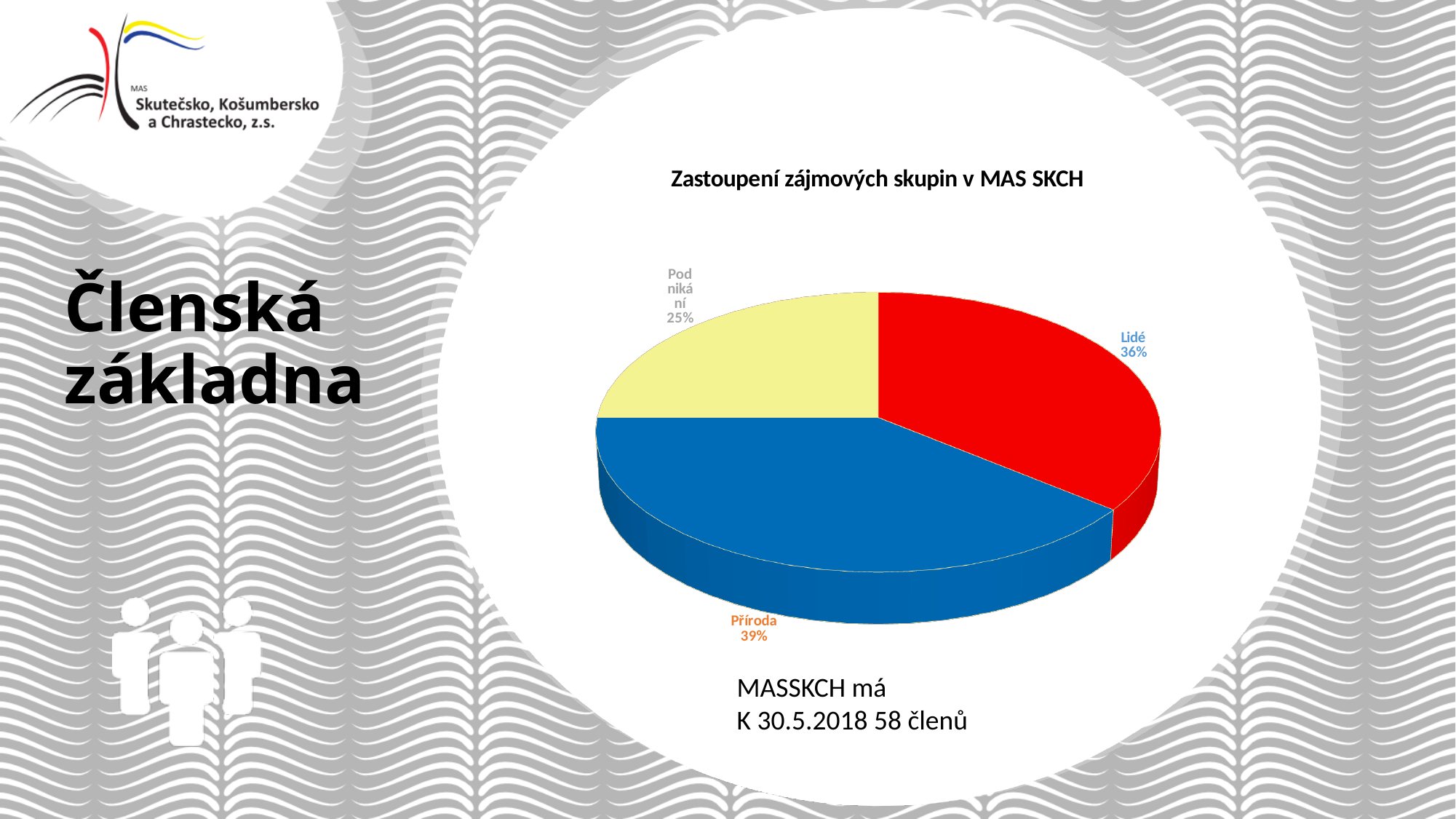
What colour is the Příroda slice of the pie chart? blue What kind of chart is shown on the slide? pie chart Which slice of the pie chart is the largest? Příroda What share of the pie does Lidé have? 36% What is the title of the chart? Zastoupení zájmových skupin v MAS SKCH What is the difference in percentage points between Příroda and Podnikání? 14 What share of the pie does Příroda have? 39% How many slices does the pie chart have? 3 What is the difference in percentage points between Lidé and Podnikání? 11 Which slice of the pie chart is the smallest? Podnikání What share of the pie does Podnikání have? 25% Which is larger, the share for Lidé or the share for Podnikání? Lidé